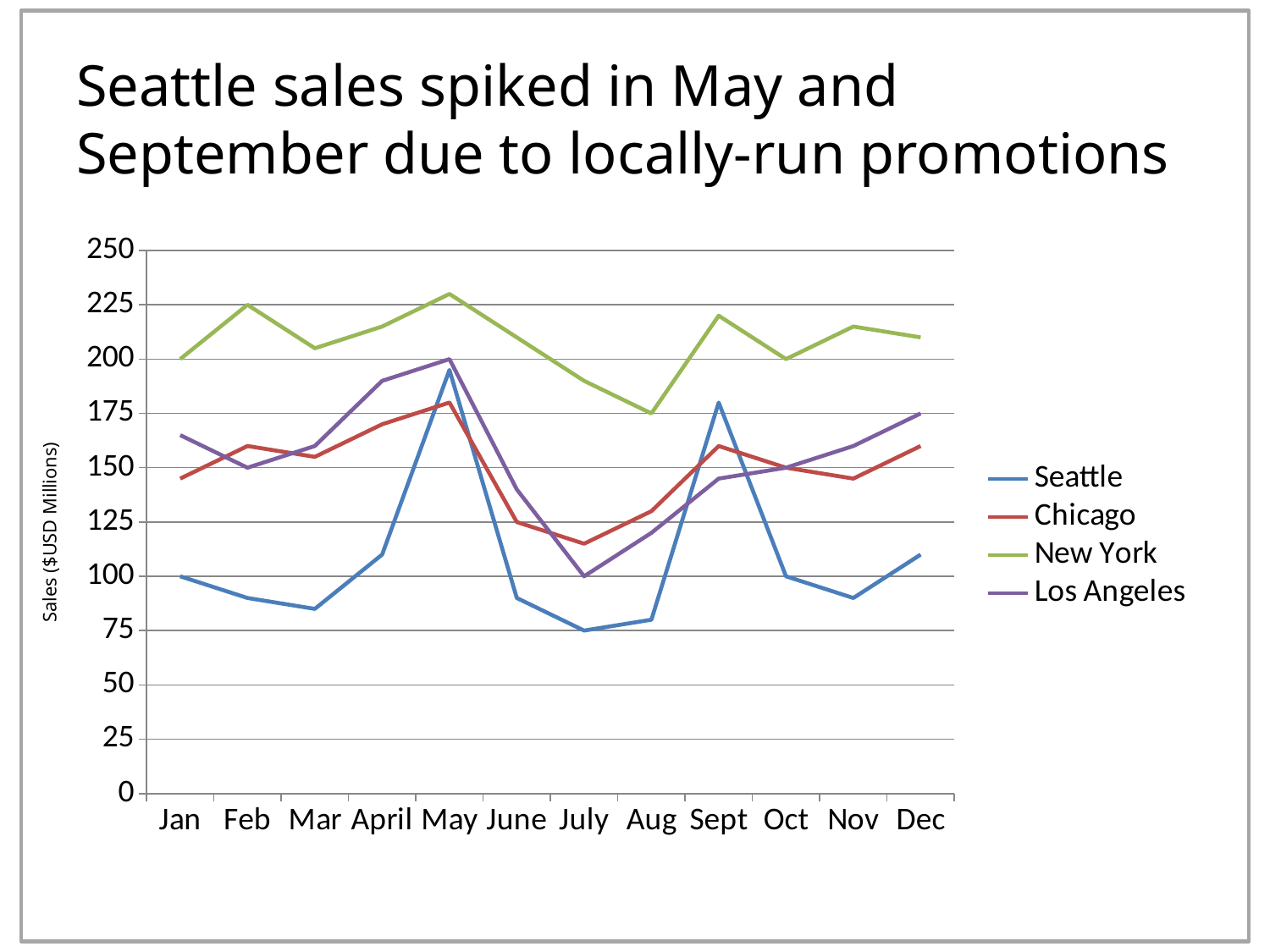
In which month does Seattle have its lowest sales? July What is the New York sales value in Jan? 200 In which month does New York reach its highest sales? May Is the Seattle value in May greater or less than 175? greater What is the Los Angeles sales value in July? 100 What is the Seattle sales value in July? 75 What is the Seattle sales value in Jan? 100 Which is larger in April, Chicago or Los Angeles? Los Angeles How many months are plotted along the x axis? 12 What type of chart is shown on the slide? Line chart How many series does the legend list? 4 Do New York sales rise or fall from May to Aug? Fall